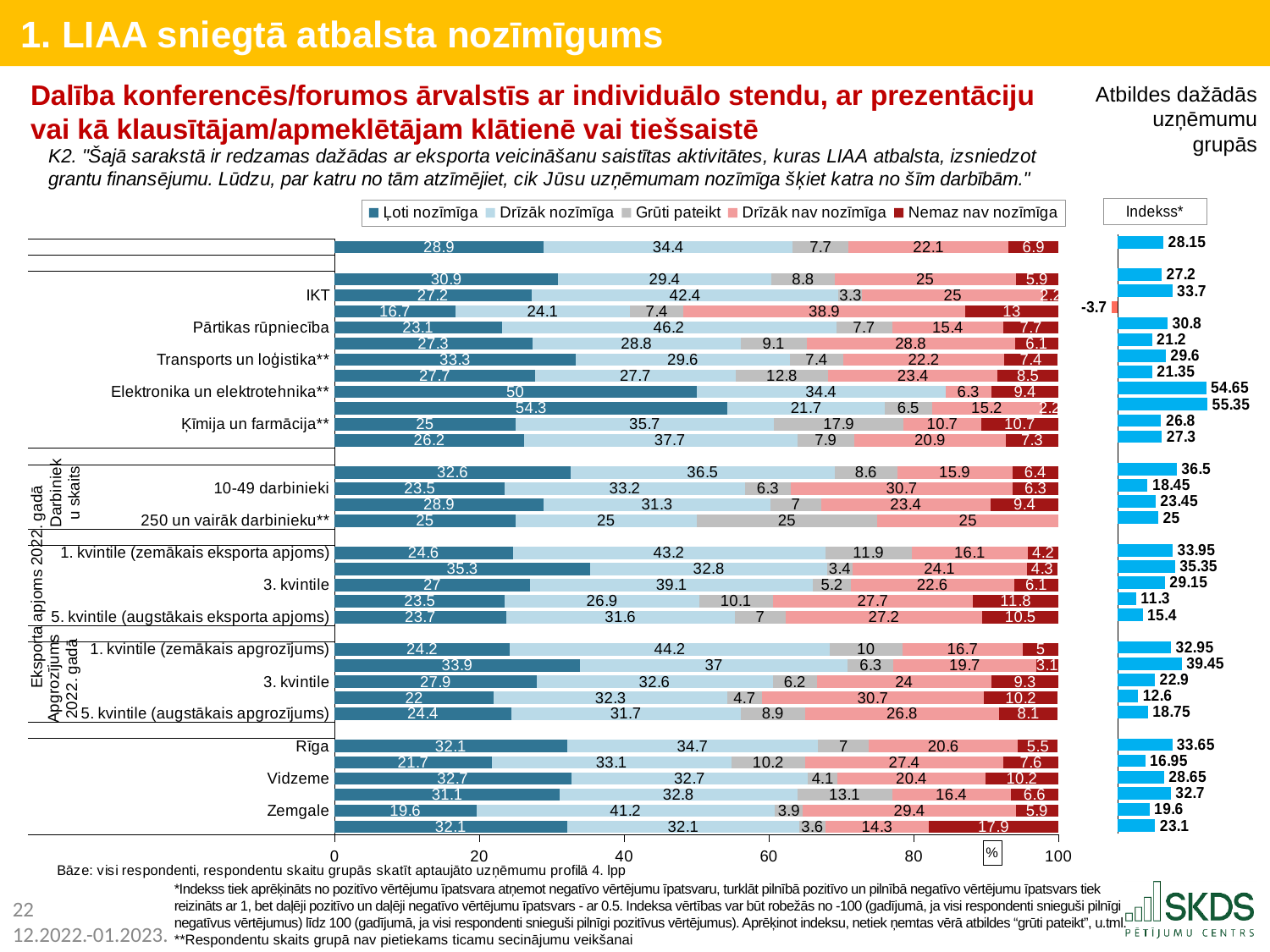
In the Indekss* chart, what is the index value for IKT? 33.7 In the main chart, what is the total of the bar for 250 un vairāk darbinieku**? 100 How many series does the legend of the main chart list? 5 In the main chart, what is the difference between the "Ļoti nozīmīga" values for Rīga and Zemgale? 12.5 In the Indekss* chart, what is the index value for Pārtikas rūpniecība? 30.8 In the main chart, what is the "Ļoti nozīmīga" value for Rīga? 32.1 In the main chart, what is the "Ļoti nozīmīga" value for Elektronika un elektrotehnika**? 50 In the Indekss* chart, which of Rīga, Vidzeme and Zemgale has the highest index value? Rīga In the Indekss* chart, is the index value for 5. kvintile (augstākais eksporta apjoms) greater or less than 20? less In the Indekss* chart, which is larger: the index for Transports un loģistika** or for Ķīmija un farmācija**? Transports un loģistika** In the main chart, what is the "Drīzāk nozīmīga" value for Zemgale? 41.2 What type of chart is the main chart on the slide? stacked bar chart